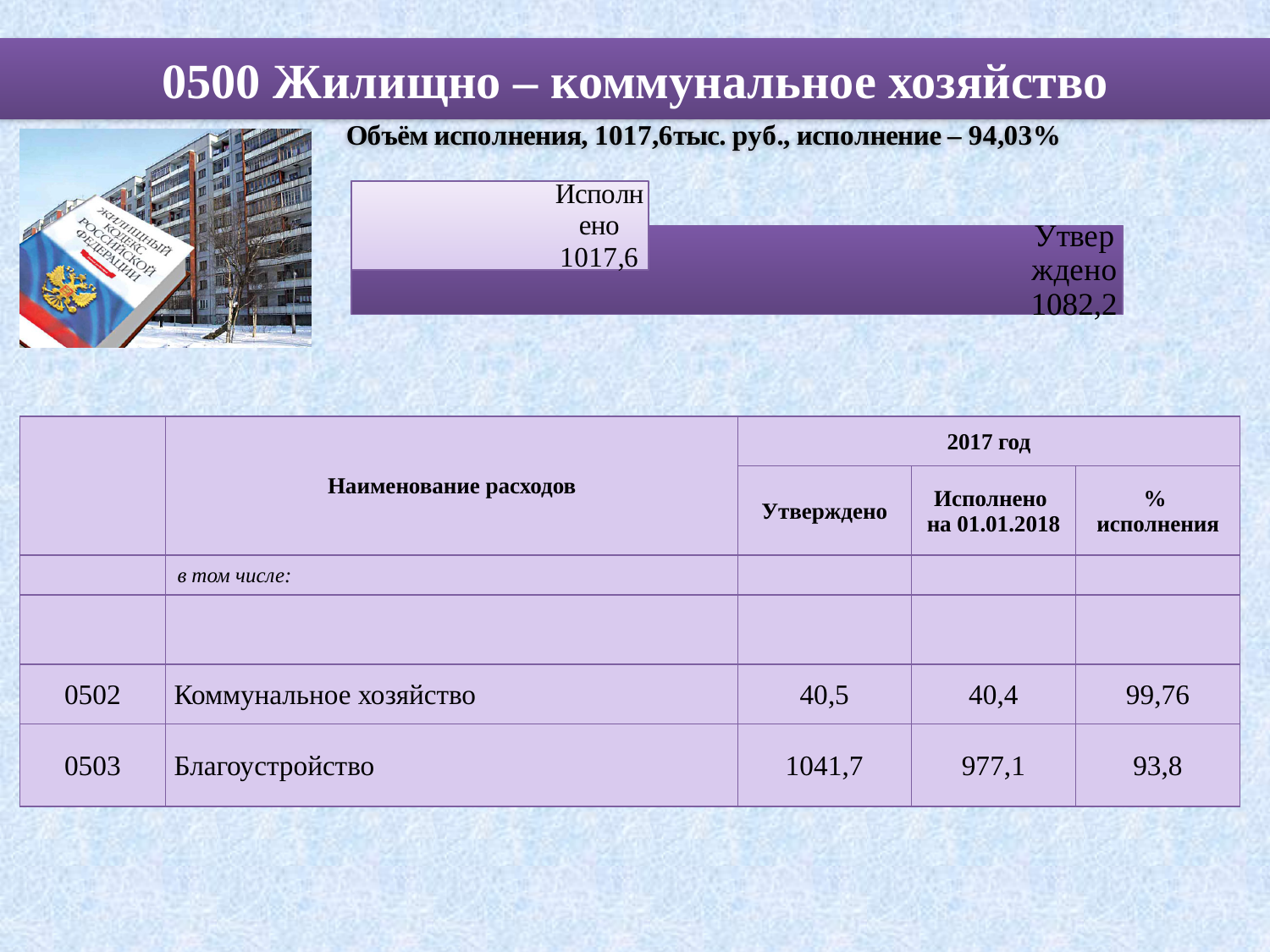
Which bar in the chart has the higher value? Утверждено What value is shown for the "Утверждено" bar in the chart? 1082,2 Are the bars in the chart oriented horizontally or vertically? horizontally How many bars does the chart contain? 2 What is the difference between the "Утверждено" and "Исполнено" values in the chart? 64,6 Which bar in the chart has the lower value? Исполнено Which bar in the chart is drawn in the darker purple colour? Утверждено What type of chart is shown on the slide? bar chart Is the value for "Исполнено" larger or smaller than the value for "Утверждено" in the chart? smaller What value is shown for the "Исполнено" bar in the chart? 1017,6